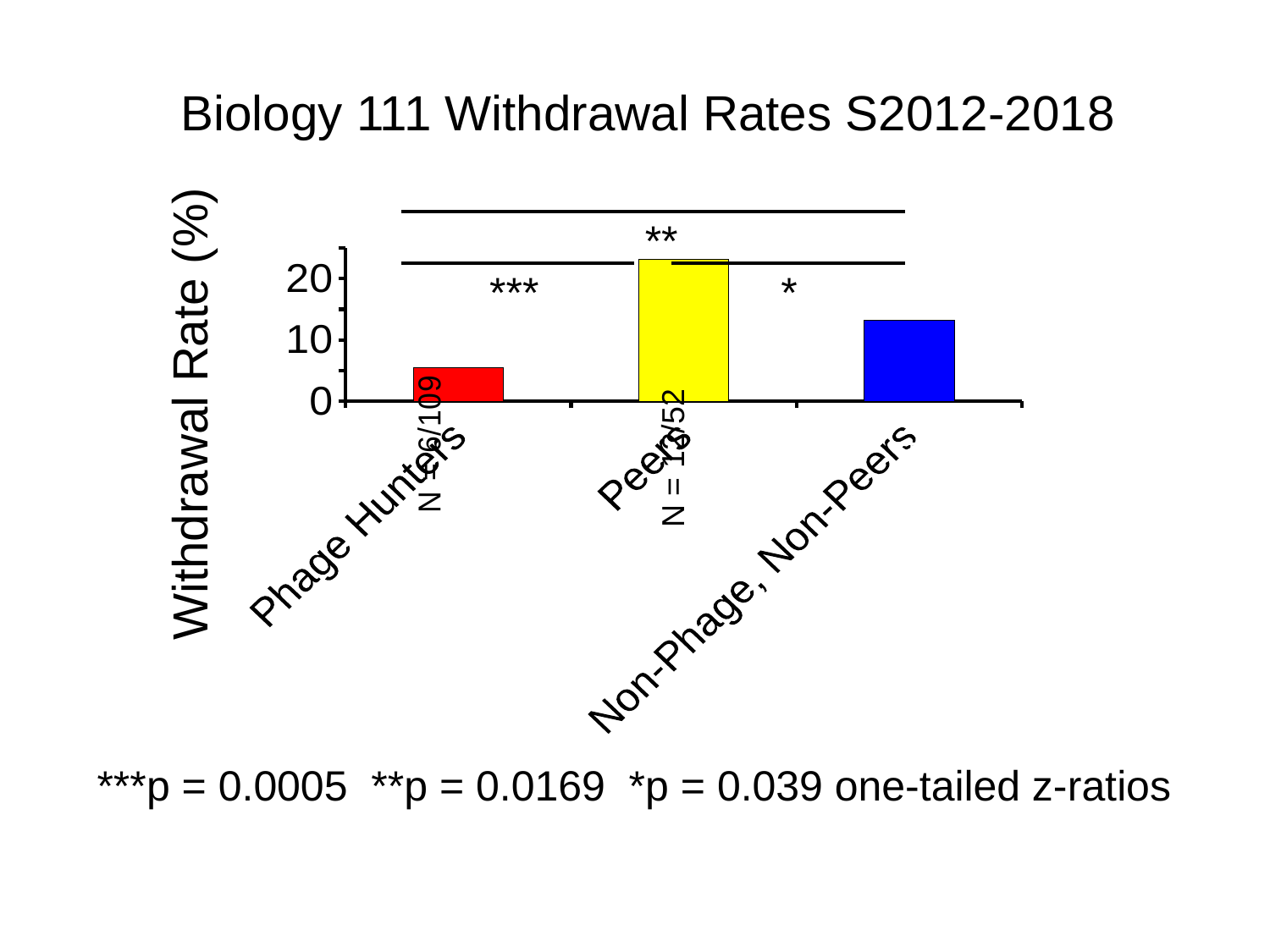
How many categories are plotted on the x axis? 3 Is the withdrawal rate for Phage Hunters greater or less than 10? less Which has a higher withdrawal rate, Phage Hunters or Non-Phage, Non-Peers? Non-Phage, Non-Peers Which has a higher withdrawal rate, Peers or Non-Phage, Non-Peers? Peers Which category has the lowest withdrawal rate? Phage Hunters Which category has the highest withdrawal rate? Peers Is the withdrawal rate for Peers greater or less than 20? greater What is the label of the y axis? Withdrawal Rate (%) What is the title of the chart? Biology 111 Withdrawal Rates S2012-2018 What kind of chart is shown on the slide? bar chart Is the withdrawal rate for Non-Phage, Non-Peers greater or less than 10? greater